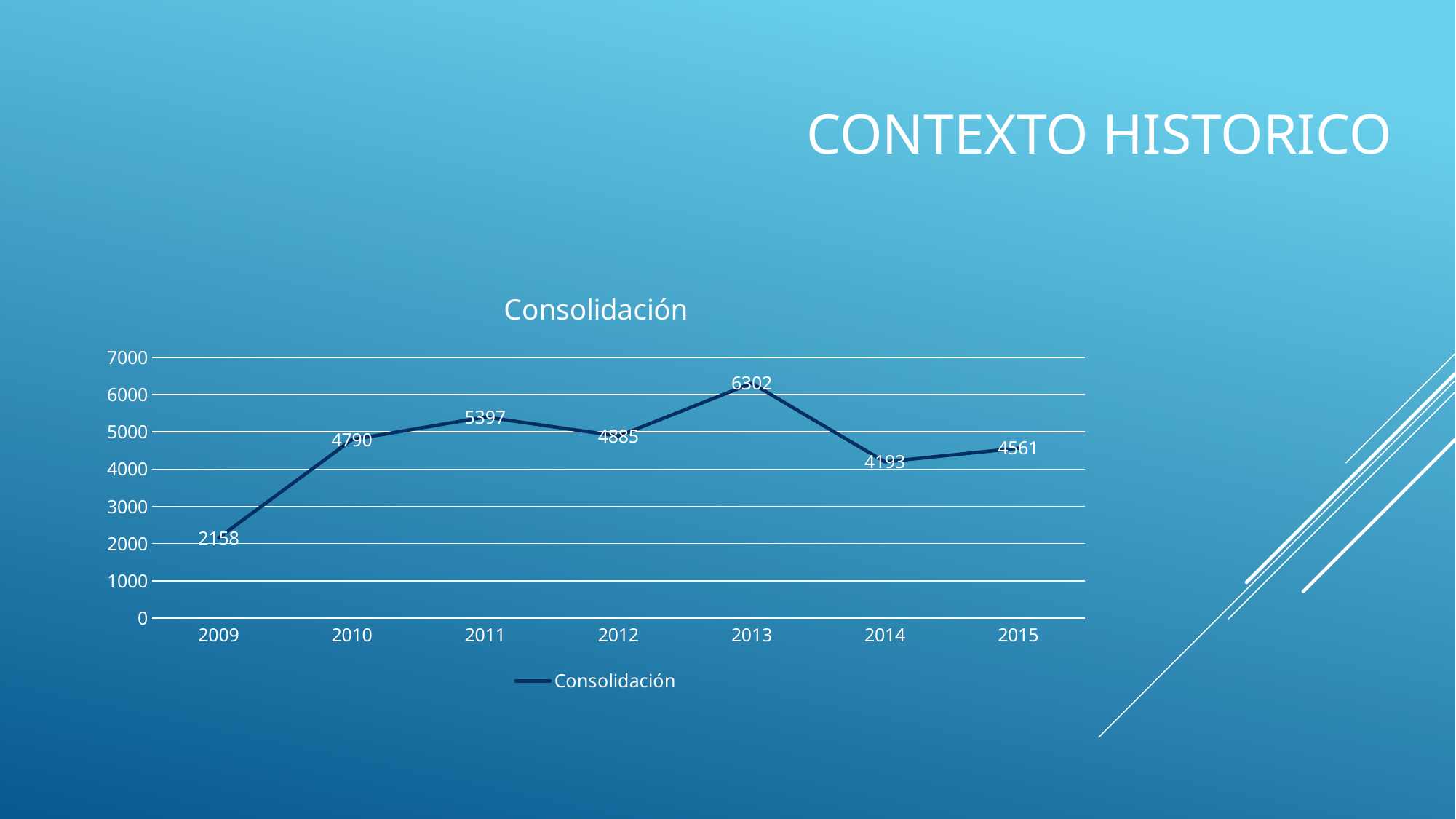
What is the value for 2013? 6302 What is the difference between the values for 2010 and 2009? 2632 What is the value for 2015? 4561 What is the title of the chart? Consolidación Which year has the lowest value? 2009 What kind of chart is shown? line chart Is the value for 2014 greater or less than 5000? less What is the difference between the values for 2013 and 2014? 2109 Which year has the highest value? 2013 Which is larger, the value for 2011 or the value for 2012? 2011 How many years are plotted on the chart? 7 What is the value for 2009? 2158